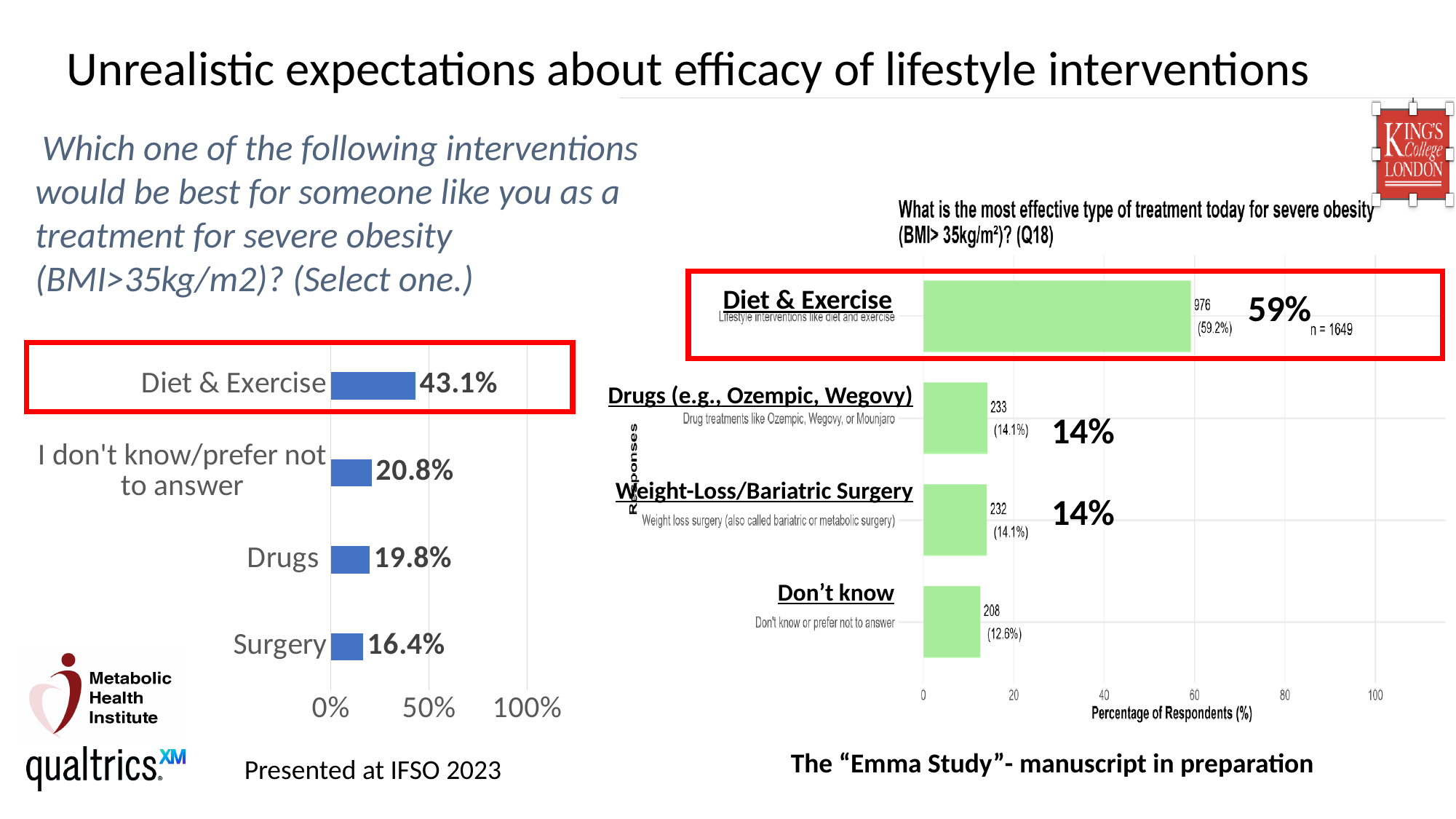
In the right chart (green bars), what is the difference in respondent counts between Drugs and Weight-Loss/Bariatric Surgery? 1 In the right chart (green bars), what percentage chose Don't know? 12.6% In the right chart (green bars), what is the total number of respondents (n) shown? n = 1649 In the left chart (blue bars), what is the difference between Diet & Exercise and Drugs? 23.3% In the left chart (blue bars), what percentage chose Diet & Exercise? 43.1% In the left chart (blue bars), which is larger: I don't know/prefer not to answer or Drugs? I don't know/prefer not to answer In the right chart (green bars), how many respondents chose Diet & Exercise? 976 What type of chart is the left chart with blue bars? Bar chart In the left chart (blue bars), what percentage chose Surgery? 16.4% In the right chart (green bars), which category has the highest value? Diet & Exercise In the left chart (blue bars), how many categories are shown? 4 In the left chart (blue bars), which category has the lowest value? Surgery